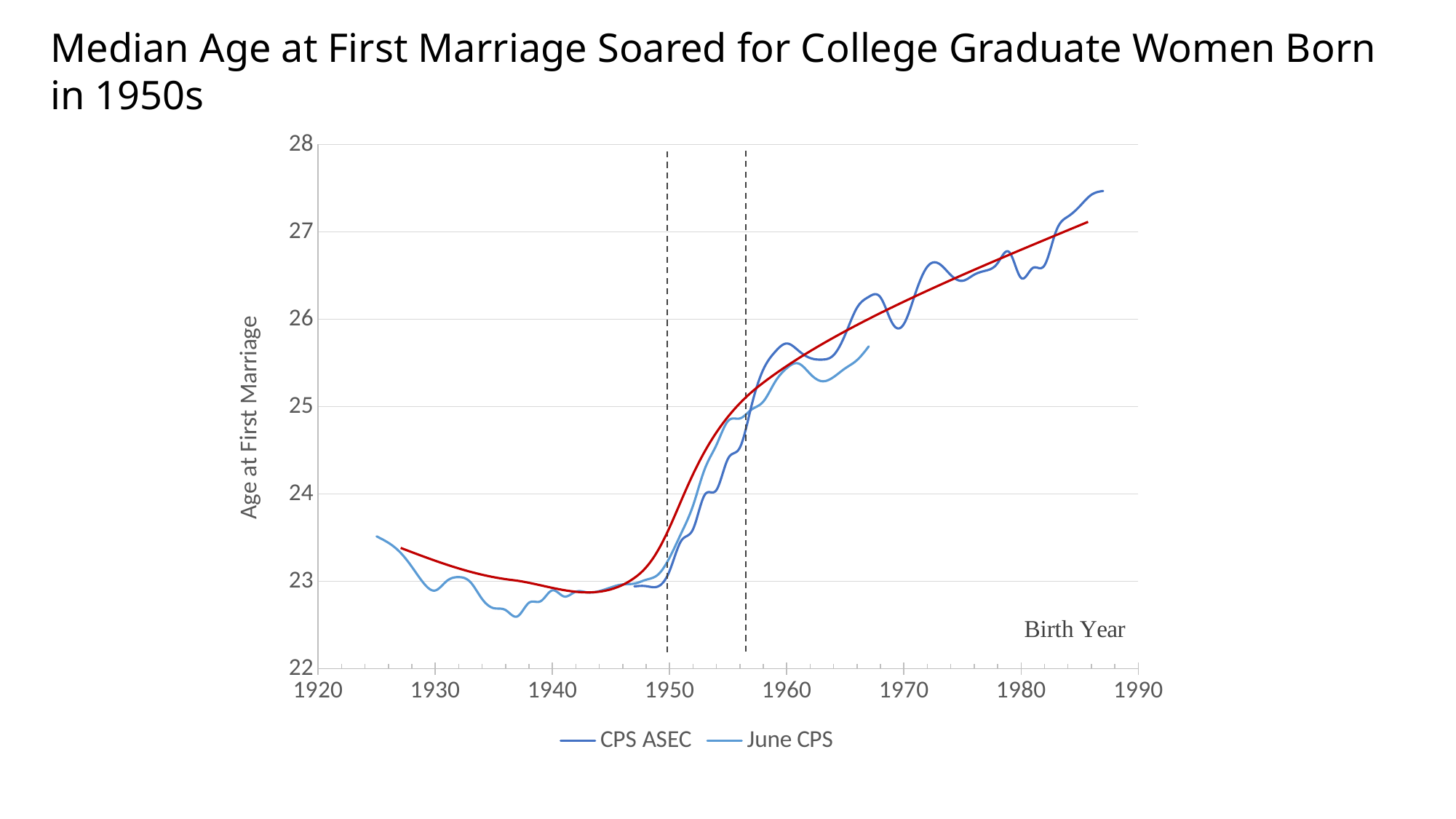
Is the CPS ASEC value for birth year 1987 greater or less than 27? greater Is the CPS ASEC value for birth year 1960 greater or less than 25? greater Is the CPS ASEC value for birth year 1980 greater or less than 26? greater Does the June CPS line rise or fall between birth years 1925 and 1937? fall Does the CPS ASEC line rise or fall between birth years 1950 and 1960? rise What kind of chart is shown on the slide? Line chart Which is larger for CPS ASEC: the value at birth year 1950 or at birth year 1980? 1980 What is the label of the horizontal axis? Birth Year What is the label of the vertical axis? Age at First Marriage How many series does the legend list? 2